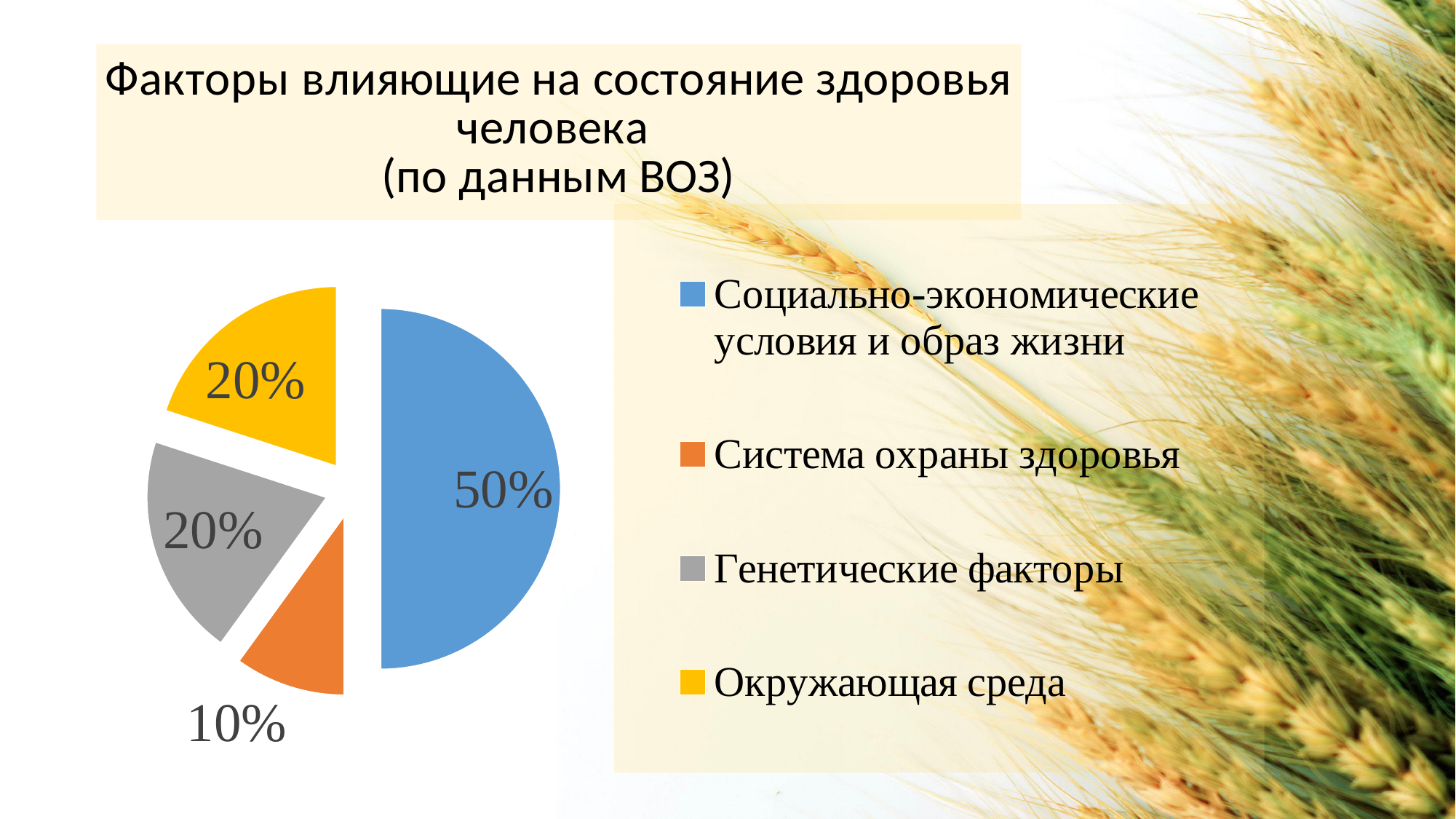
What share of the pie is labelled for Генетические факторы? 20% Which category has the smallest slice of the pie? Система охраны здоровья What is the difference between the shares for Социально-экономические условия и образ жизни and Система охраны здоровья? 40% Which category has the largest slice of the pie? Социально-экономические условия и образ жизни What kind of chart is shown on the slide? pie chart How many categories does the legend list? 4 What share of the pie is labelled for Окружающая среда? 20% What is the title of the slide containing the chart? Факторы влияющие на состояние здоровья человека (по данным ВОЗ) What share of the pie is labelled for Система охраны здоровья? 10% Which is larger: the share for Генетические факторы or the share for Система охраны здоровья? Генетические факторы What share of the pie is labelled for Социально-экономические условия и образ жизни? 50% What colour is the slice for Окружающая среда? yellow